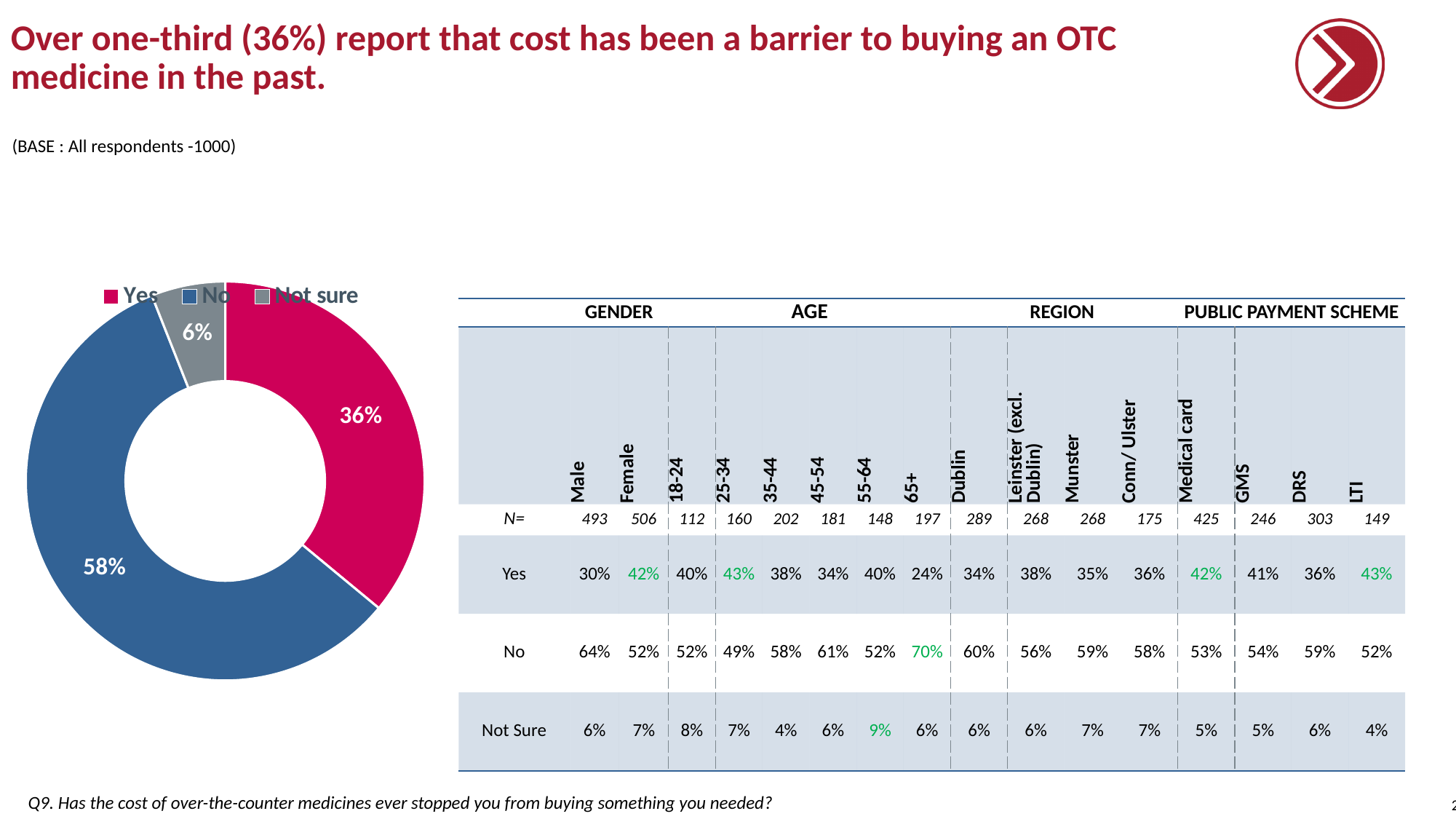
What colour is the 'Yes' slice in the pie chart? Red (magenta) How many entries does the pie chart legend list? 3 What percentage of respondents answered 'No' in the pie chart? 58% What percentage of respondents answered 'Yes' in the pie chart? 36% Which response has the largest share of the pie chart? No What kind of chart is shown on the slide? Pie chart (doughnut) How many slices does the pie chart have? 3 What percentage of respondents answered 'Not sure' in the pie chart? 6% Which slice is larger in the pie chart, 'Yes' or 'Not sure'? Yes Which response has the smallest share of the pie chart? Not sure What is the combined share of the 'Yes' and 'No' slices in the pie chart? 94% What is the difference in percentage points between the 'No' and 'Yes' slices of the pie chart? 22